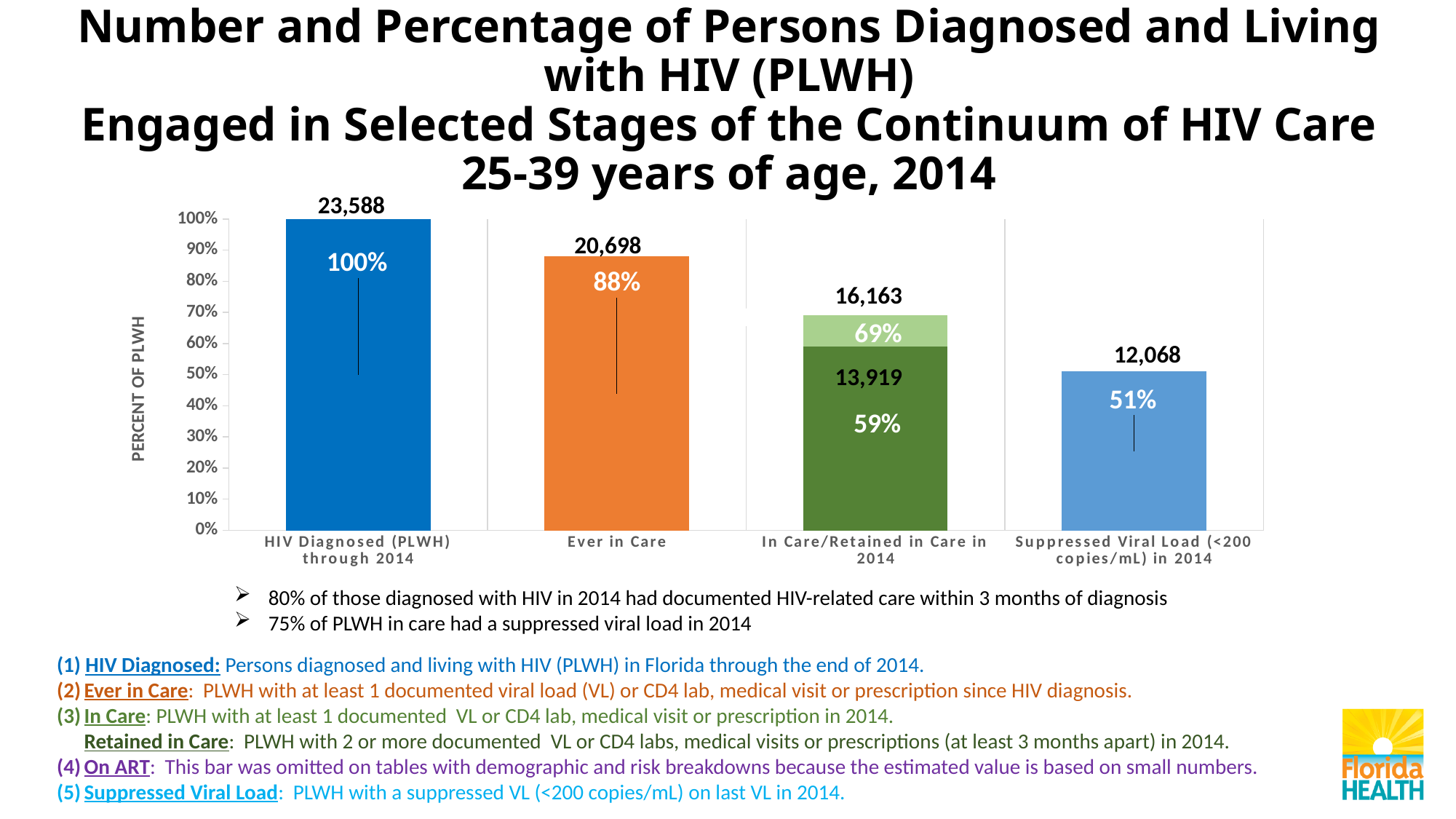
What percentage of PLWH were 'Ever in Care'? 88% What kind of chart is shown on the slide? Bar chart What percentage is shown for the darker green 'Retained in Care' portion of the 'In Care/Retained in Care in 2014' bar? 59% Do the percentages rise or fall moving from left to right across the x axis? Fall What is the number of persons for 'HIV Diagnosed (PLWH) through 2014'? 23,588 How many categories are shown on the x axis of the chart? 4 What is the number of persons labelled at the top of the 'In Care/Retained in Care in 2014' bar? 16,163 Which category has the highest number of persons? HIV Diagnosed (PLWH) through 2014 What is the difference in number of persons between 'HIV Diagnosed (PLWH) through 2014' and 'Ever in Care'? 2,890 Which category has the lowest number of persons? Suppressed Viral Load (<200 copies/mL) in 2014 What percentage of PLWH had a 'Suppressed Viral Load (<200 copies/mL) in 2014'? 51% What is the number of persons for 'Ever in Care'? 20,698